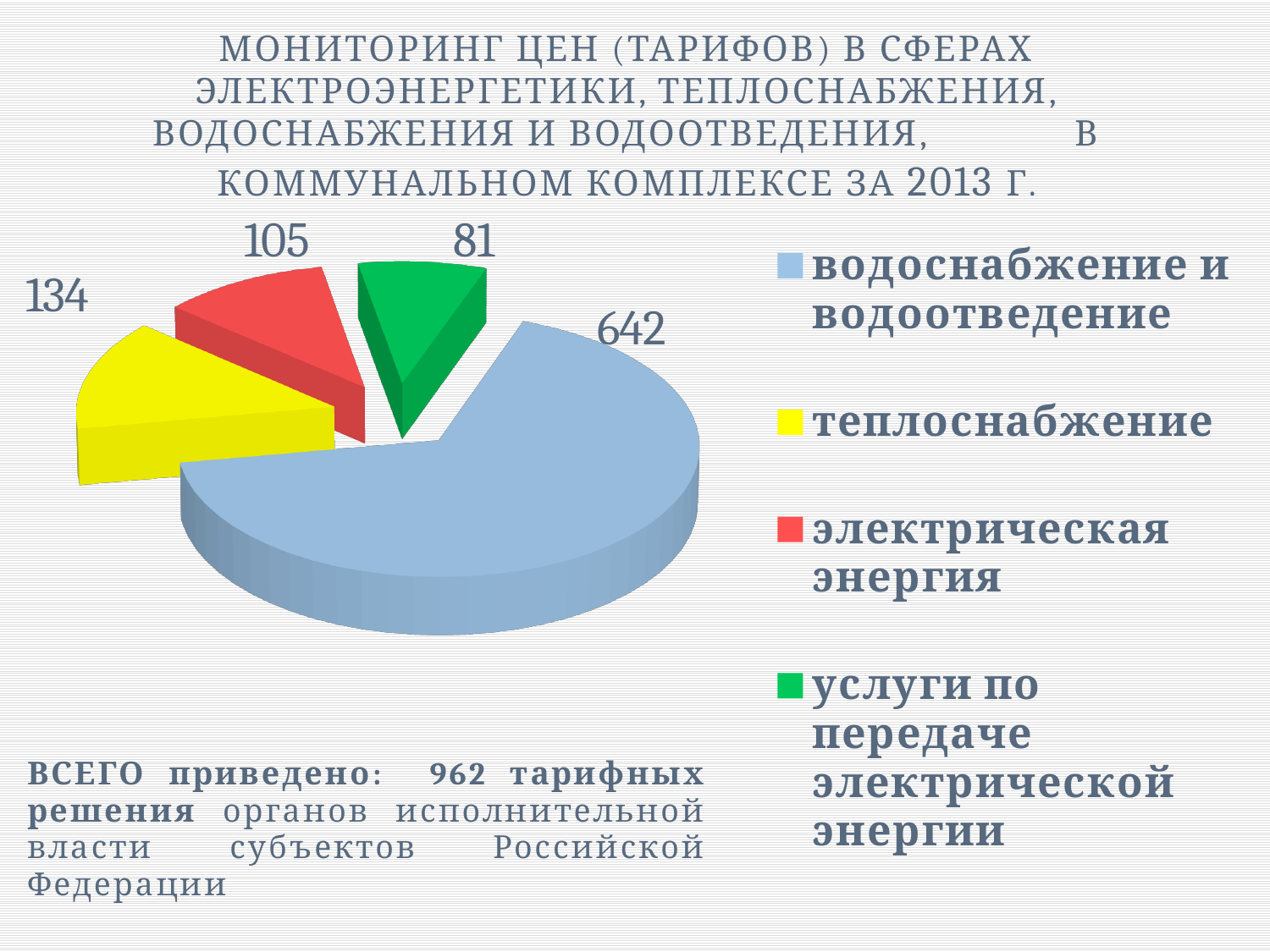
What is the value for услуги по передаче электрической энергии? 81 Which category has the smallest slice of the pie? услуги по передаче электрической энергии What is the value for водоснабжение и водоотведение? 642 What colour is the slice for теплоснабжение? yellow What is the difference between the values for электрическая энергия and услуги по передаче электрической энергии? 24 What is the difference between the values for водоснабжение и водоотведение and теплоснабжение? 508 What is the value for электрическая энергия? 105 Which is larger, the value for теплоснабжение or the value for электрическая энергия? теплоснабжение What is the value for теплоснабжение? 134 What type of chart is shown on the slide? pie chart Which category has the largest slice of the pie? водоснабжение и водоотведение How many categories does the pie chart have? 4